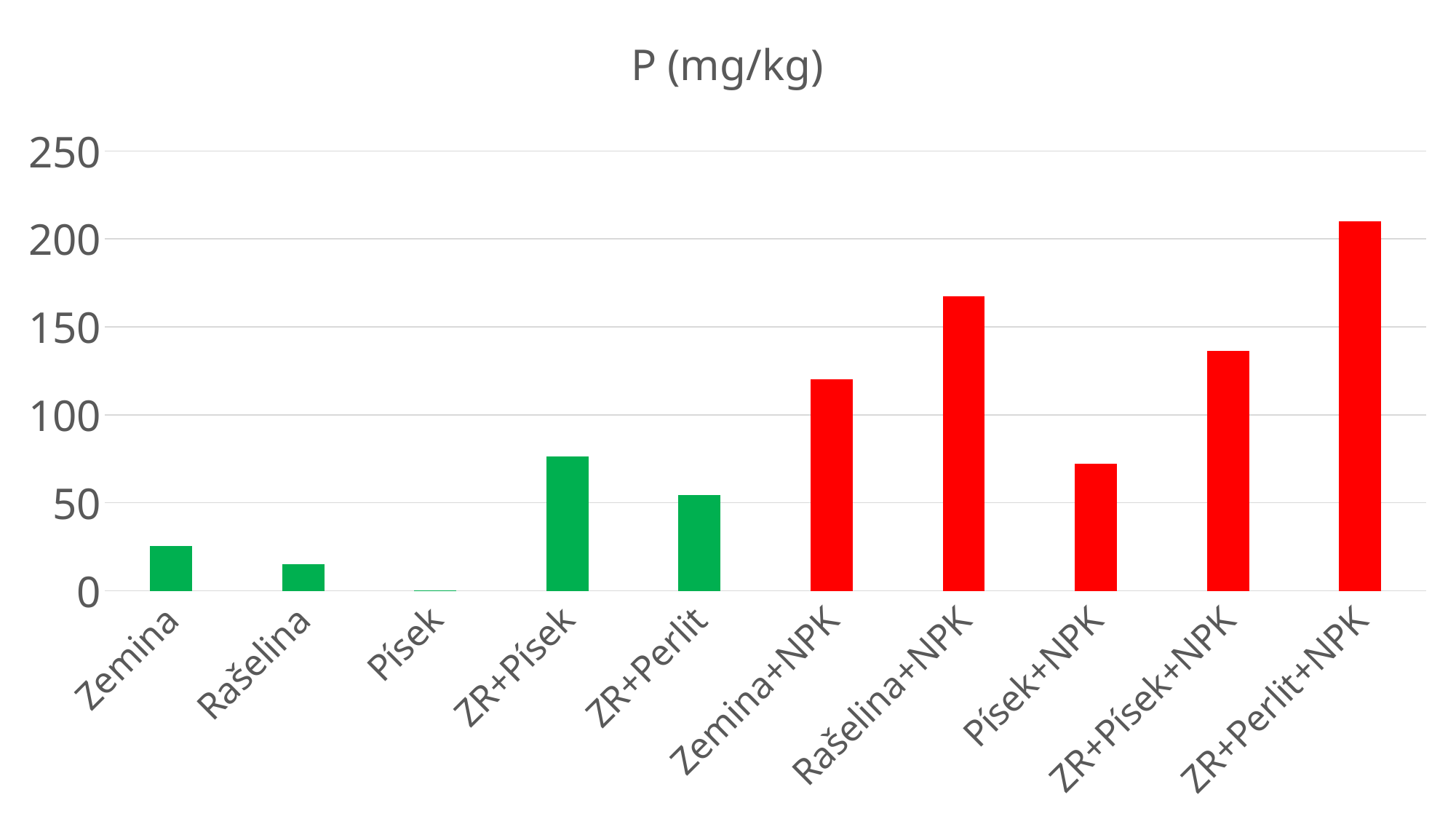
What colour are the bars for the categories with NPK? red Is the value for ZR+Písek greater or less than 100? less Which is larger, the value for ZR+Písek or the value for ZR+Perlit? ZR+Písek What is the title of the chart? P (mg/kg) Is the value for Rašelina+NPK greater or less than 150? greater Which is larger, the value for Zemina+NPK or the value for Písek+NPK? Zemina+NPK Which category has the highest value in the chart? ZR+Perlit+NPK Is the value for ZR+Perlit+NPK greater or less than 200? greater Which category has the lowest value in the chart? Písek What kind of chart is shown on the slide? bar chart How many categories are shown on the x axis of the chart? 10